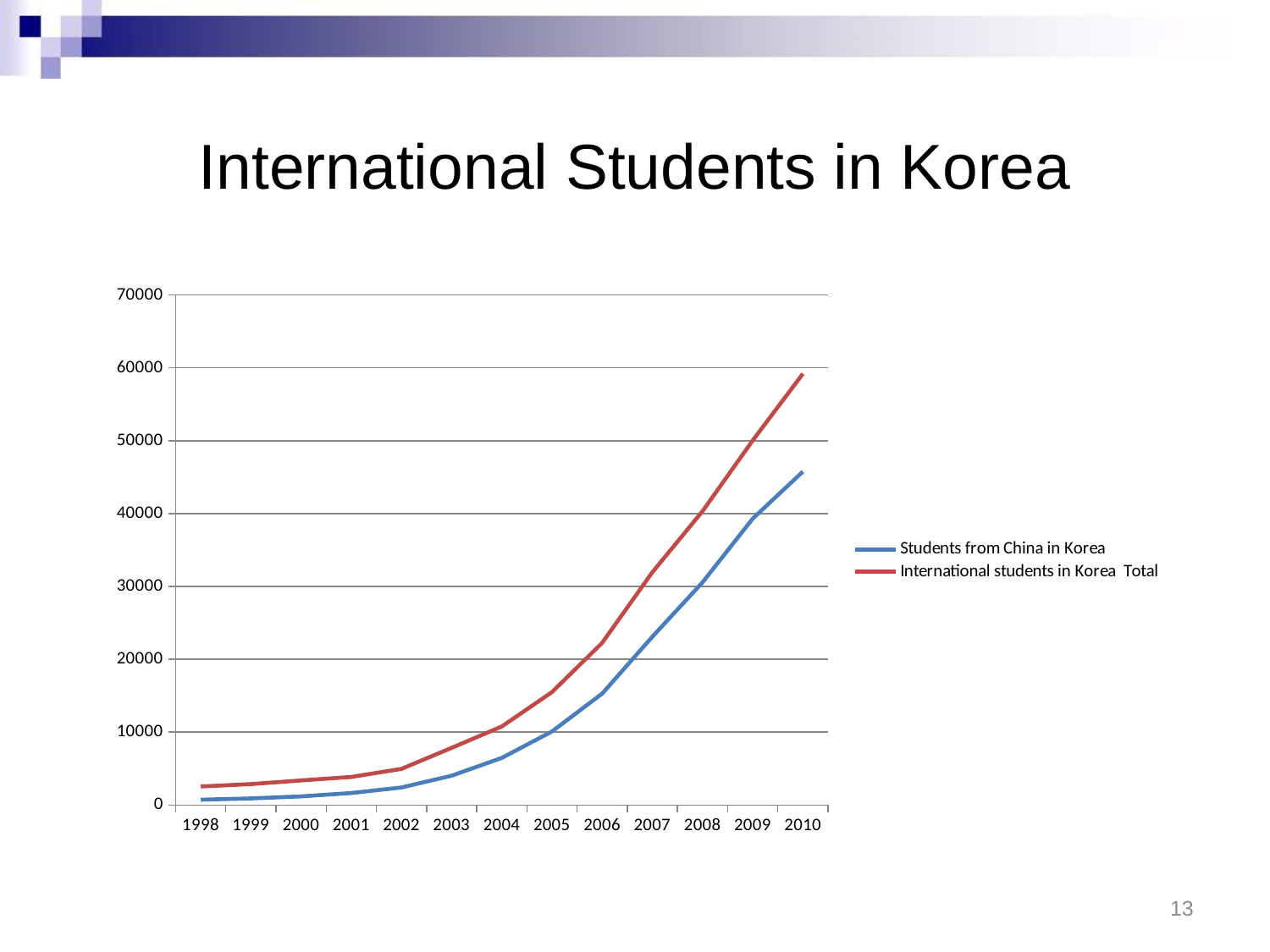
In 2010, which is larger: International students in Korea Total or Students from China in Korea? International students in Korea Total How many years are plotted along the x axis? 13 What is the title of the slide containing the chart? International Students in Korea In which year is the value for Students from China in Korea lowest? 1998 In which year is the value for International students in Korea Total highest? 2010 How many series does the legend list? 2 Is the value for International students in Korea Total in 2010 greater or less than 50000? greater Do the values for Students from China in Korea rise or fall from 1998 to 2010? rise Which series is drawn in red? International students in Korea Total What kind of chart is shown on the slide? line chart Is the value for Students from China in Korea in 2006 greater or less than 20000? less Is the value for Students from China in Korea in 2010 greater or less than 50000? less